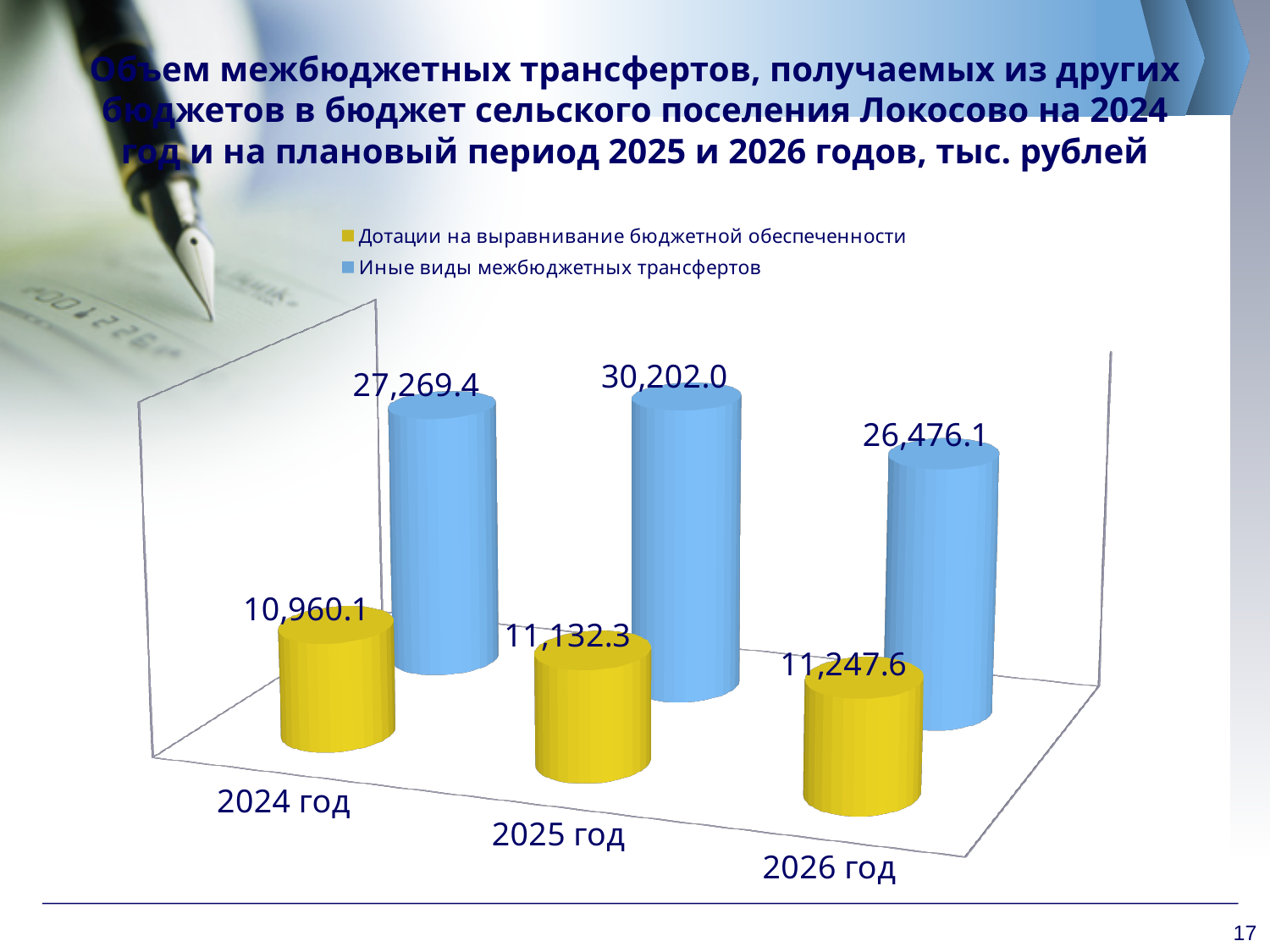
In which year is Дотации на выравнивание бюджетной обеспеченности lowest? 2024 год What is the value of Иные виды межбюджетных трансфертов for 2026 год? 26,476.1 What is the value of Дотации на выравнивание бюджетной обеспеченности for 2024 год? 10,960.1 What is the value of Дотации на выравнивание бюджетной обеспеченности for 2026 год? 11,247.6 Do the values for Дотации на выравнивание бюджетной обеспеченности rise or fall from 2024 год to 2026 год? rise What is the value of Иные виды межбюджетных трансфертов for 2025 год? 30,202.0 What is the difference between Дотации на выравнивание бюджетной обеспеченности in 2026 год and 2024 год? 287.5 In which year is Иные виды межбюджетных трансфертов highest? 2025 год Which is larger in 2026 год: Дотации на выравнивание бюджетной обеспеченности or Иные виды межбюджетных трансфертов? Иные виды межбюджетных трансфертов What is the difference between Иные виды межбюджетных трансфертов in 2025 год and 2024 год? 2,932.6 How many years are shown on the x axis of the chart? 3 How many series does the legend list? 2